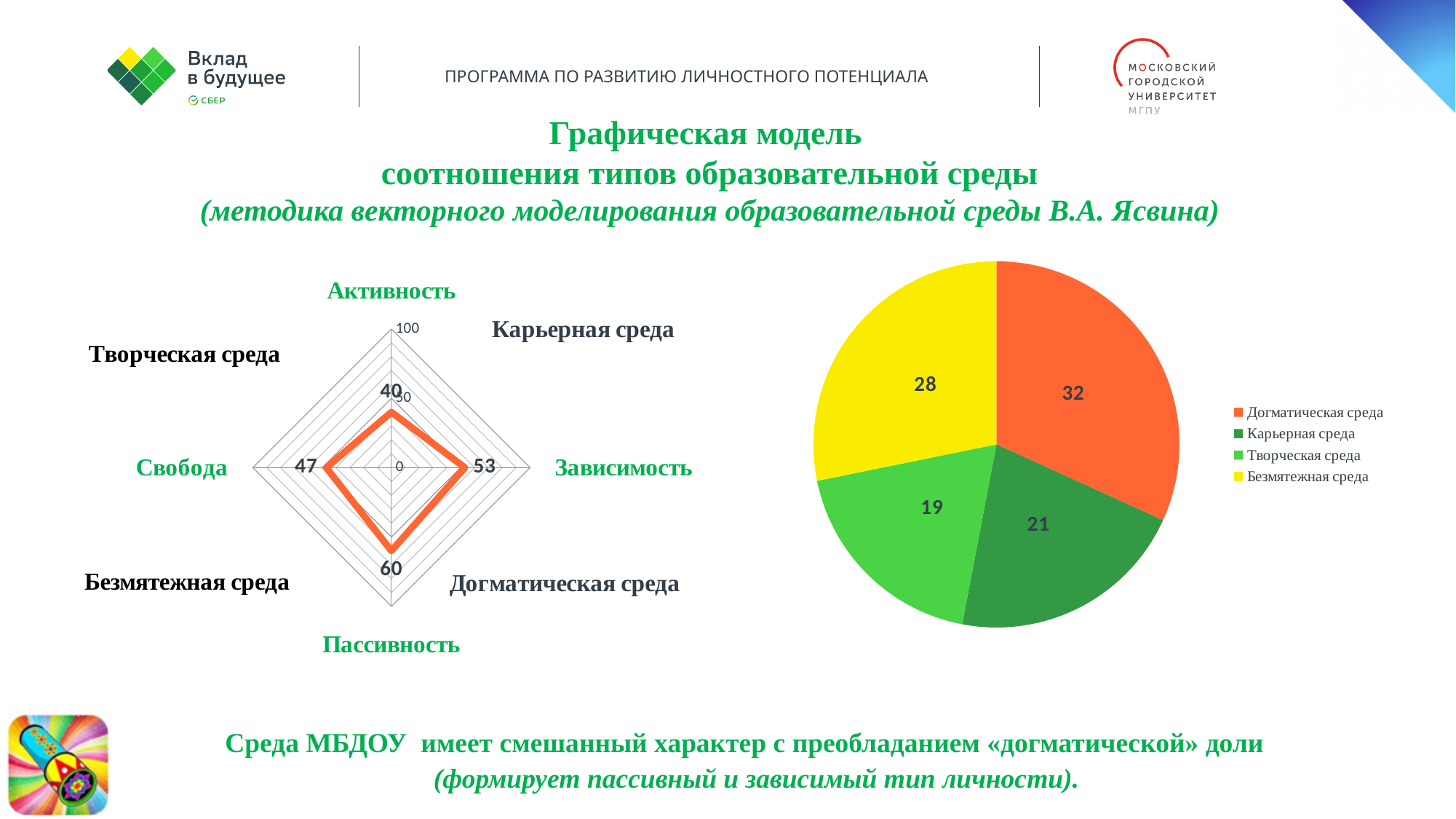
On the radar chart on the left, which axis has the highest value? Пассивность On the pie chart, which category has the smallest slice? Творческая среда On the radar chart on the left, what is the value for Активность? 40 On the pie chart, what colour is the slice for Безмятежная среда? Yellow On the radar chart on the left, what is the difference between the values for Зависимость and Свобода? 6 On the pie chart, what is the value for Догматическая среда? 32 On the radar chart on the left, what is the value for Пассивность? 60 On the pie chart, which is larger: Безмятежная среда or Карьерная среда? Безмятежная среда On the pie chart, which category has the largest slice? Догматическая среда On the pie chart, what is the difference between the values for Догматическая среда and Карьерная среда? 11 On the pie chart, what is the value for Творческая среда? 19 How many categories does the legend of the pie chart list? 4